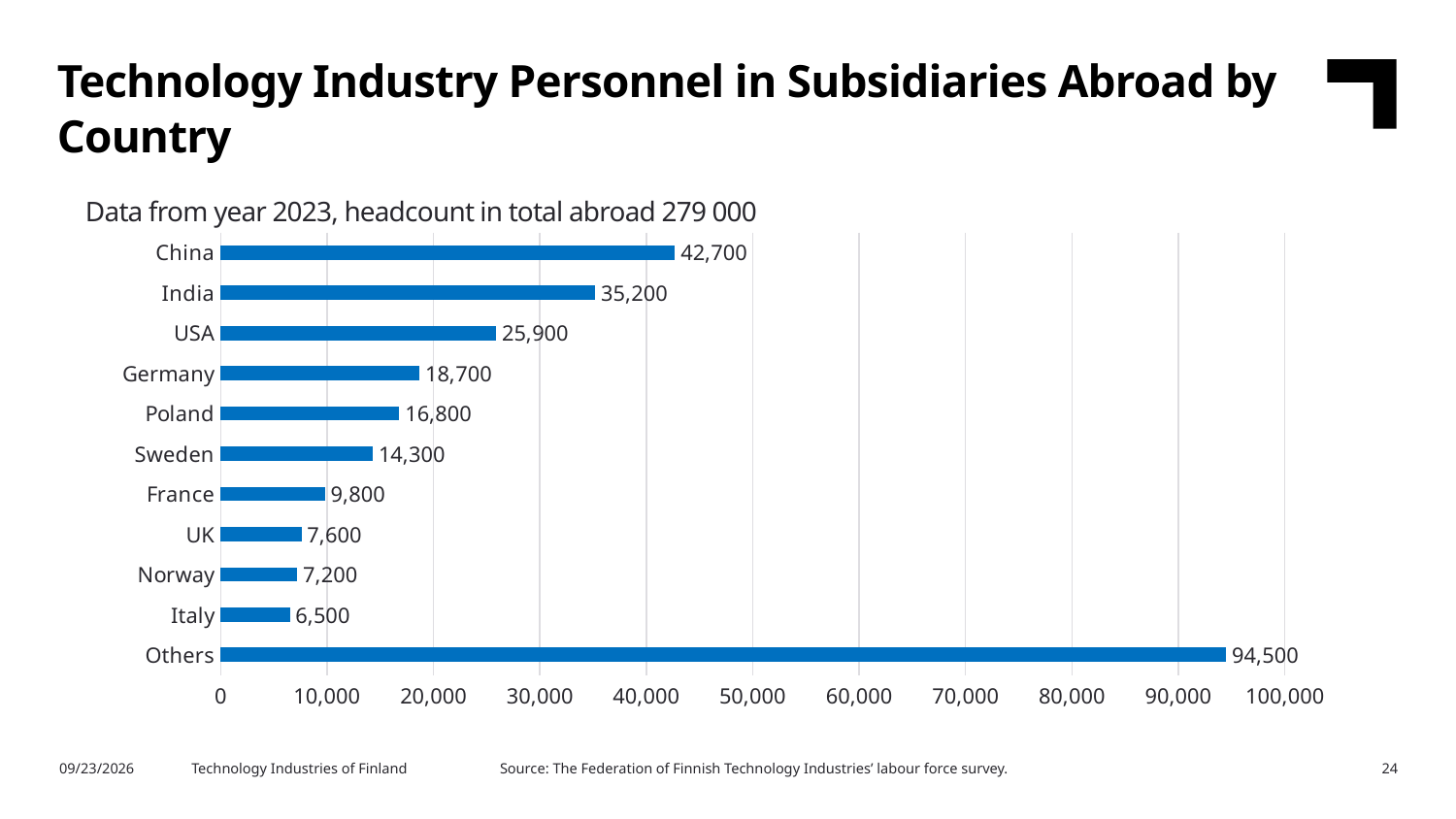
Which has a larger headcount, USA or Germany? USA What is the headcount for Norway? 7,200 How many categories are shown in the chart? 11 Which named country has the lowest headcount? Italy Is the headcount for France greater or less than 10,000? less What is the difference in headcount between China and India? 7,500 What is the total headcount abroad stated in the chart subtitle? 279 000 What is the headcount for China? 42,700 What kind of chart is shown on the slide? bar chart Which category has the highest headcount? Others What is the difference in headcount between Poland and Sweden? 2,500 What is the headcount for Germany? 18,700